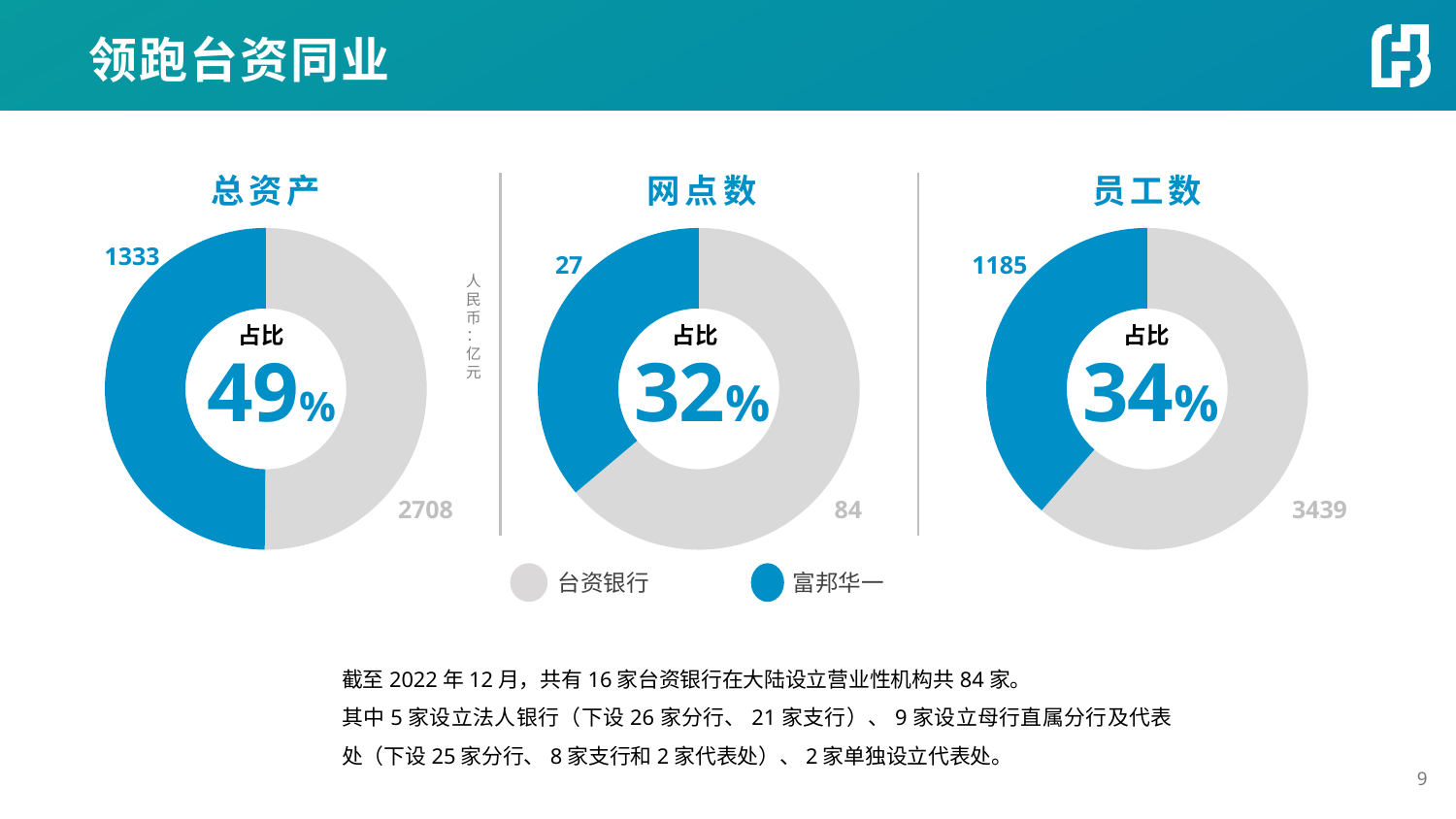
In the 员工数 chart, what is the value labelled for 富邦华一? 1185 In the 员工数 chart, what share (占比) is shown in the centre? 34% In the 网点数 chart, what is the value labelled for 台资银行? 84 In the 总资产 chart, what is the value labelled for 富邦华一? 1333 What kind of chart is used for 总资产? Donut (pie) chart In the 总资产 chart, what is the value labelled for 台资银行? 2708 In the 员工数 chart, what is the difference between the 台资银行 value and the 富邦华一 value? 2254 In the 总资产 chart, what share (占比) is shown in the centre? 49% Which legend entry is shown in blue? 富邦华一 How many series does the legend list? 2 In the 网点数 chart, what share (占比) is shown in the centre? 32% In the 网点数 chart, what is the value labelled for 富邦华一? 27